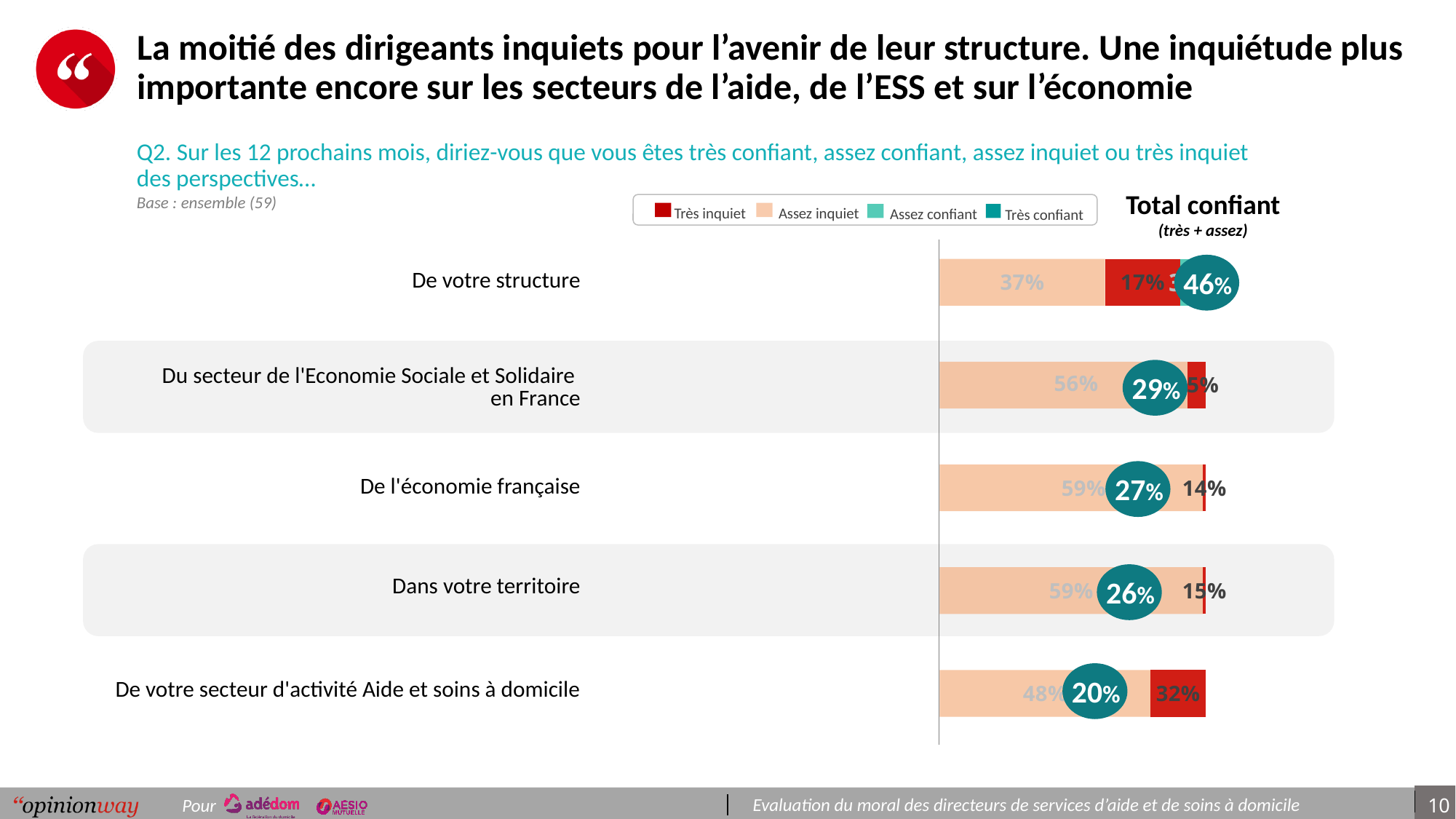
Which category has the highest 'Très inquiet' value? De votre secteur d'activité Aide et soins à domicile How many series does the legend list? 4 What is the 'Assez inquiet' value for 'De votre structure'? 37% Which has the larger 'Assez inquiet' value: 'Du secteur de l'Economie Sociale et Solidaire en France' or 'De votre structure'? Du secteur de l'Economie Sociale et Solidaire en France What kind of chart is shown on the slide? bar chart What is the 'Assez inquiet' value for 'De votre secteur d'activité Aide et soins à domicile'? 48% Which category has the highest 'Total confiant' value? De votre structure How many categories (items) are plotted in the chart? 5 What is the 'Total confiant' value for 'De votre structure'? 46% What is the difference between the 'Total confiant' values for 'De votre structure' and 'De votre secteur d'activité Aide et soins à domicile'? 26 percentage points Which category has the lowest 'Total confiant' value? De votre secteur d'activité Aide et soins à domicile What is the 'Très inquiet' value for 'De votre secteur d'activité Aide et soins à domicile'? 32%